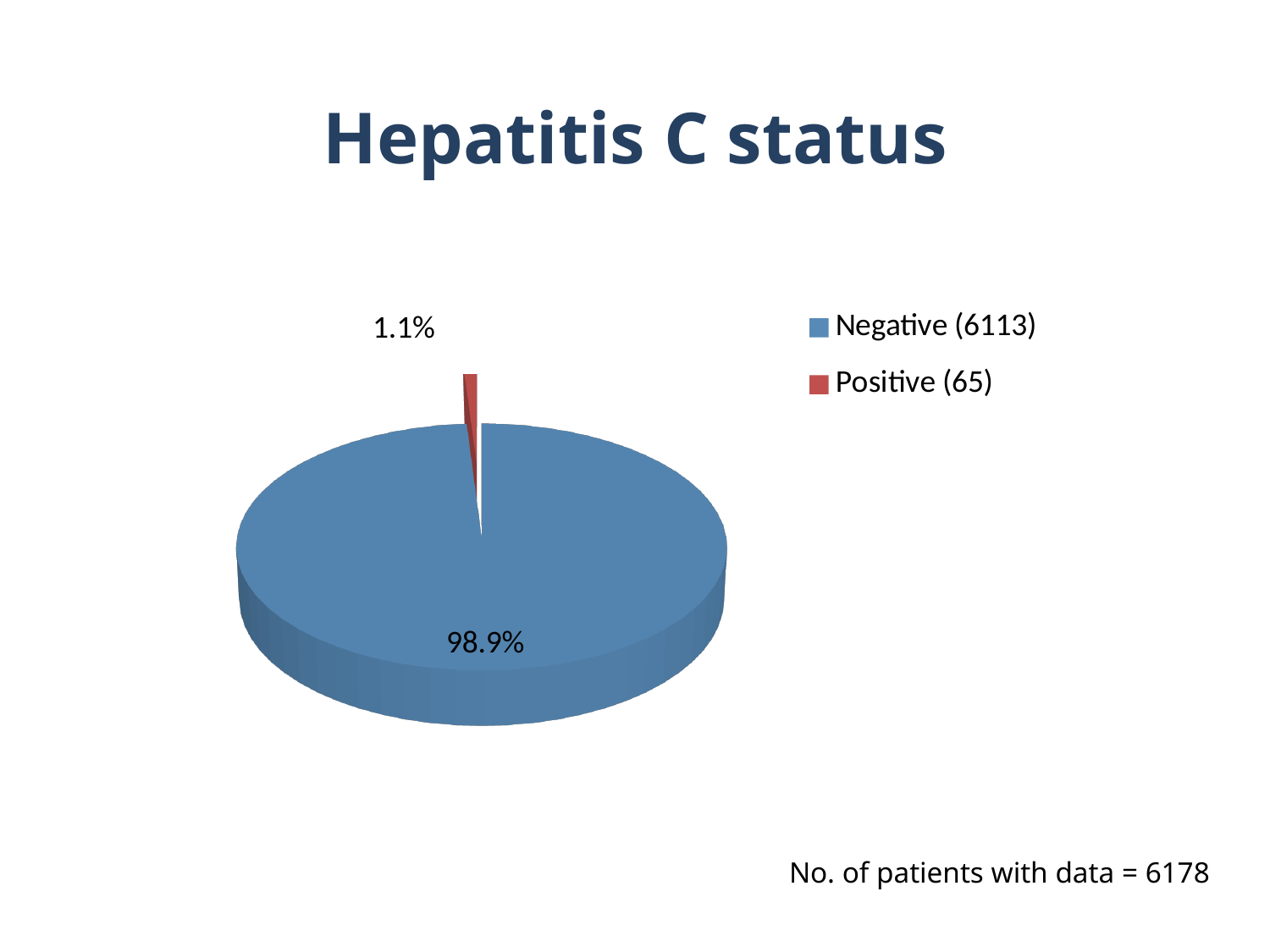
What kind of chart is shown on the slide? pie chart Which category has the largest share of the pie? Negative What colour represents the Positive category in the pie chart? red What percentage of patients are Hepatitis C negative? 98.9% Which is larger, the Negative share or the Positive share? Negative What is the difference in percentage points between the Negative and Positive shares? 97.8 What is the title of the chart? Hepatitis C status How many patients are in the Positive category according to the legend? 65 What percentage of patients are Hepatitis C positive? 1.1% How many patients are in the Negative category according to the legend? 6113 Which category has the smallest share of the pie? Positive How many categories does the pie chart show? 2